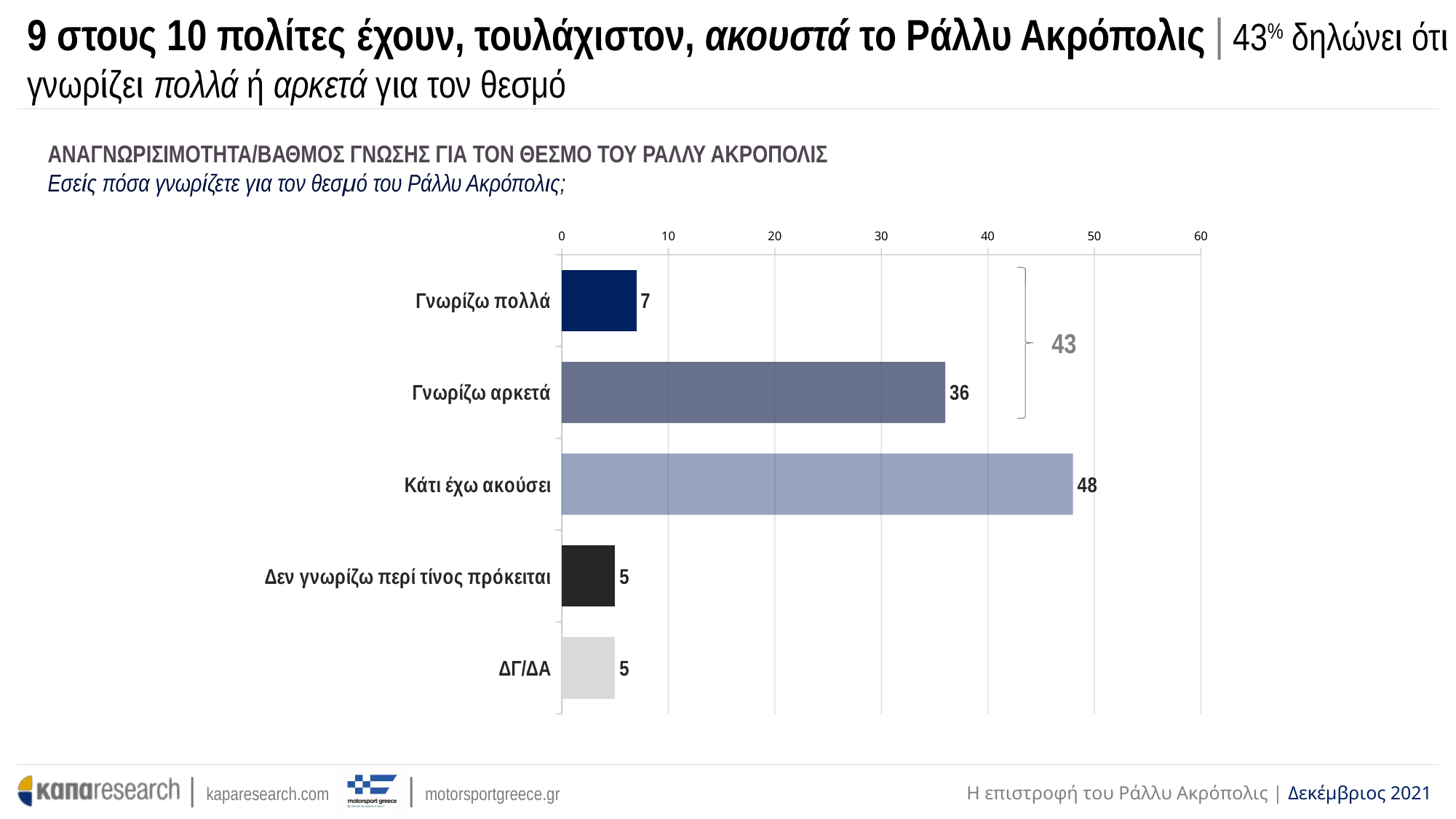
What is the value for "Γνωρίζω πολλά"? 7 What is the value for "Κάτι έχω ακούσει"? 48 What is the combined value shown by the bracket for "Γνωρίζω πολλά" and "Γνωρίζω αρκετά"? 43 What is the difference between the values for "Κάτι έχω ακούσει" and "Γνωρίζω αρκετά"? 12 Is the value for "Κάτι έχω ακούσει" greater or less than 40? greater Which is larger, the value for "Γνωρίζω πολλά" or the value for "Γνωρίζω αρκετά"? Γνωρίζω αρκετά How many categories are shown in the chart? 5 Which category has the highest value? Κάτι έχω ακούσει What is the highest value shown on the chart's axis? 60 What kind of chart is shown on the slide? bar chart What is the value for "Δεν γνωρίζω περί τίνος πρόκειται"? 5 What is the value for "Γνωρίζω αρκετά"? 36